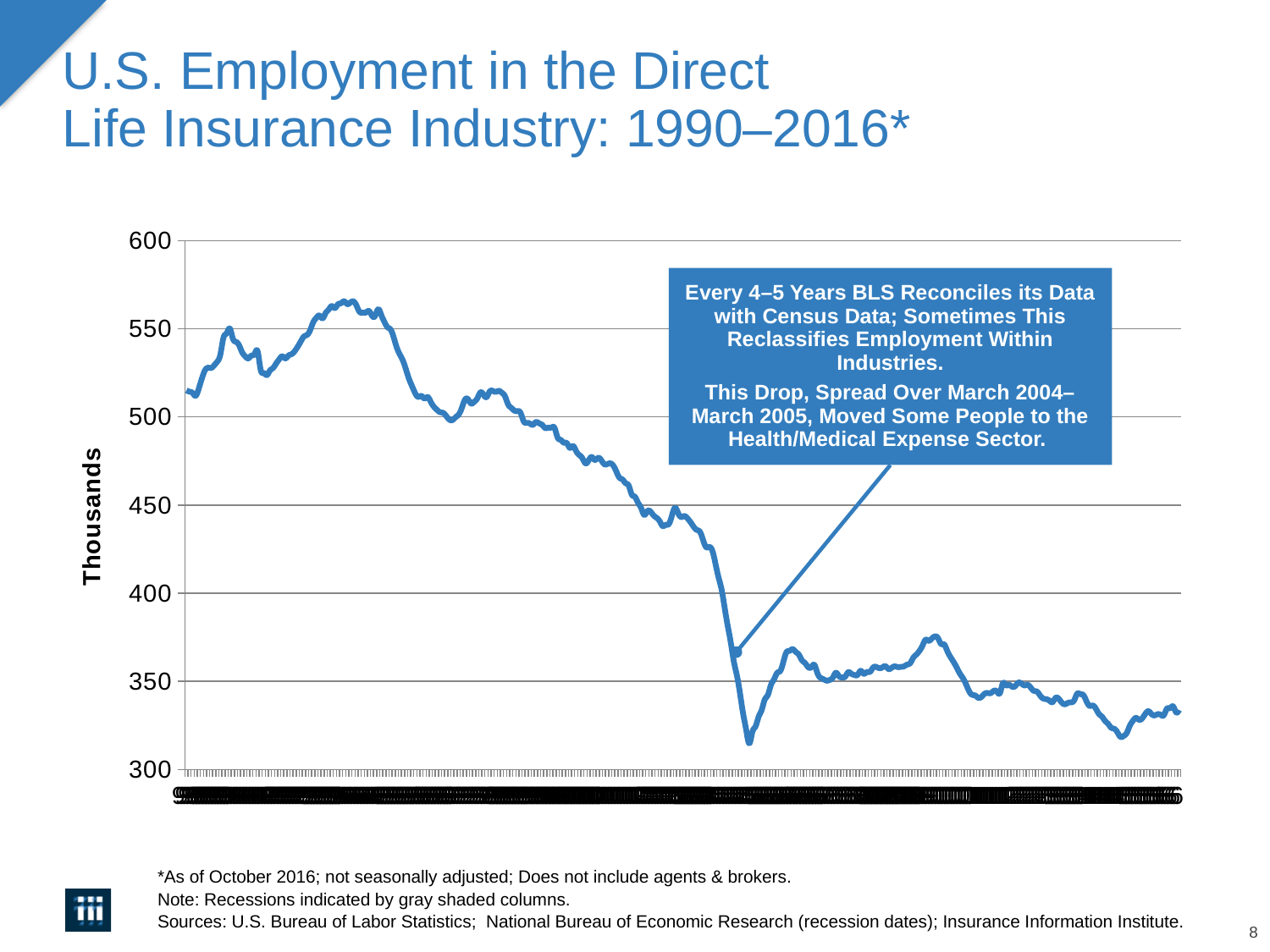
Which is larger, the value at the leftmost point of the line or the value at the rightmost point? The leftmost point Is the lowest point on the line greater or less than 350? less According to the annotation on the chart, over what period was the drop spread? March 2004–March 2005 What is the label on the vertical axis of the chart? Thousands Overall, do the employment values rise or fall from the left of the chart to the right? Fall Is the value at the leftmost point of the line greater or less than 500? greater Is the value at the rightmost point of the line greater or less than 300? greater What kind of chart is shown on the slide? Line chart